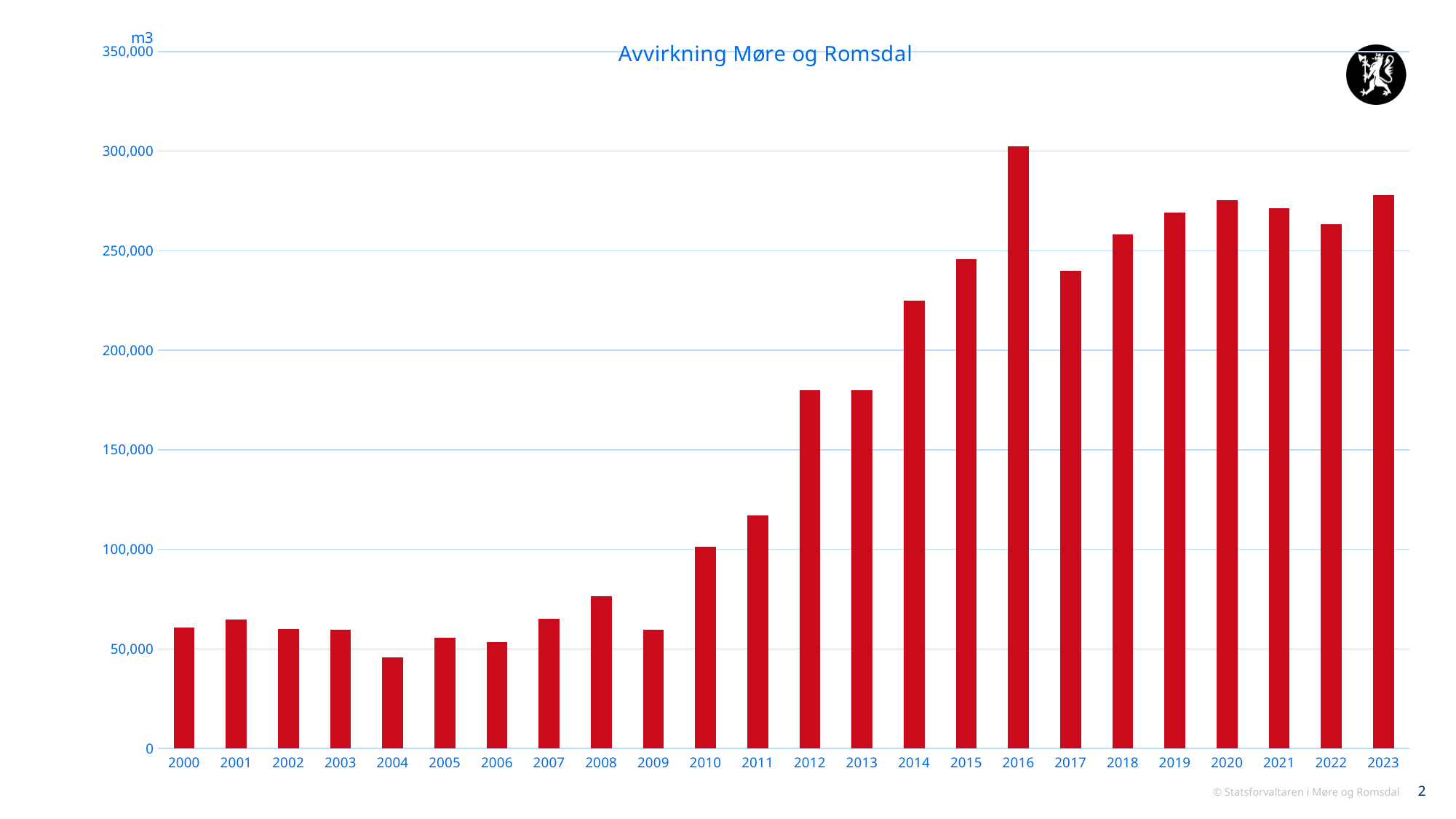
What is the title of the chart? Avvirkning Møre og Romsdal What kind of chart is shown on the slide? bar chart What unit is shown on the vertical axis of the chart? m3 Which year has the highest value in the chart? 2016 Is the value for 2017 greater or less than 250,000? less Is the value for 2016 greater or less than 250,000? greater How many years are plotted on the x axis of the chart? 24 Is the value for 2004 greater or less than 50,000? less Which year has the lowest value in the chart? 2004 Which year has the larger value, 2016 or 2023? 2016 Do the values generally rise or fall from 2009 to 2016? rise